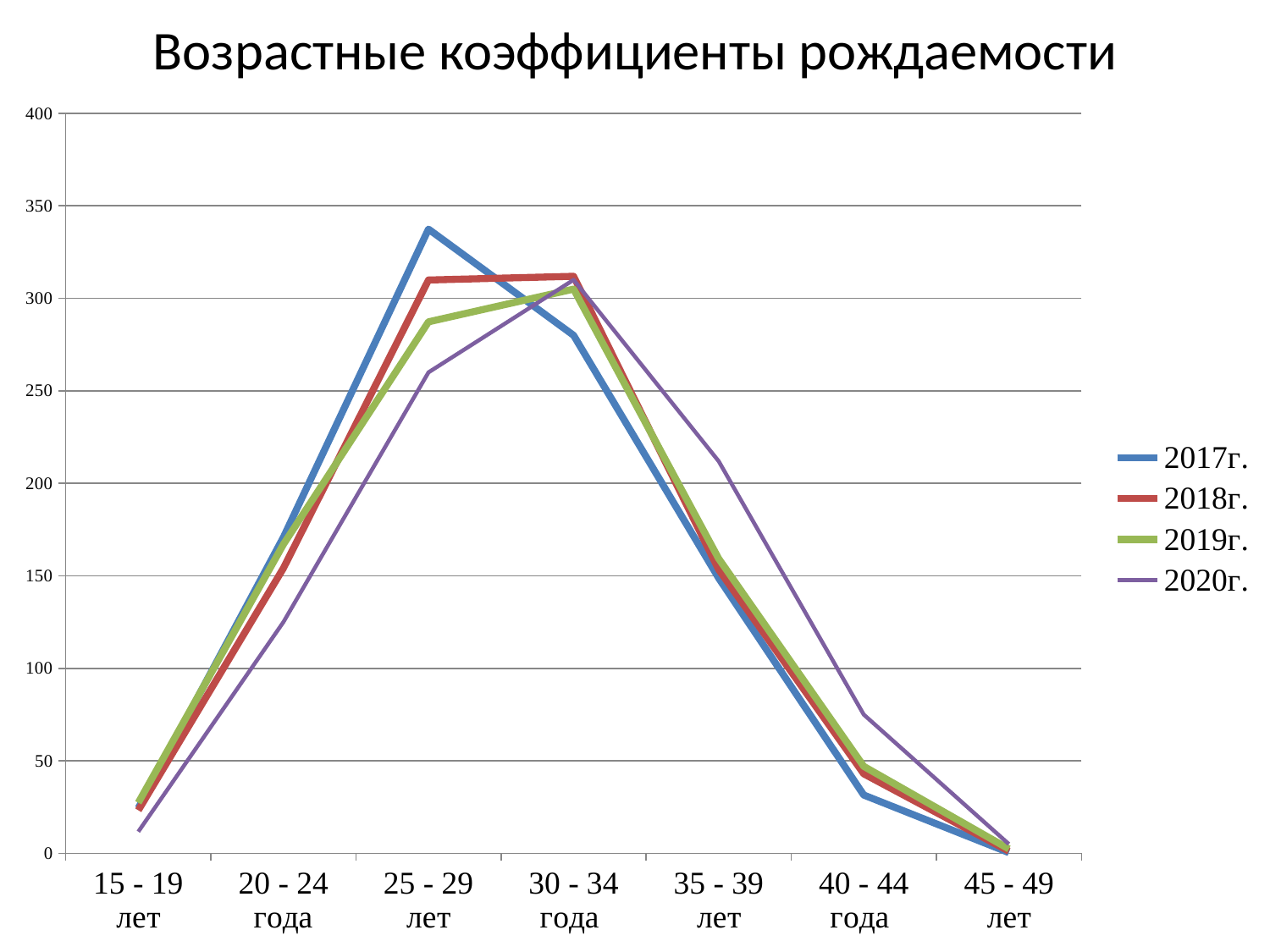
How many series does the legend list? 4 Is the 2020г. value for 40 - 44 года greater or less than 50? greater Is the 2020г. value for 25 - 29 лет greater or less than 300? less For the 35 - 39 лет age group, which series has the larger value, 2017г. or 2020г.? 2020г. For which age group is the 2017г. value highest? 25 - 29 лет For which age group is the 2020г. value lowest? 45 - 49 лет Is the 2017г. value for 25 - 29 лет greater or less than 300? greater Does the 2017г. line rise or fall from 30 - 34 года to 45 - 49 лет? fall For which age group is the 2020г. value highest? 30 - 34 года What is the title of the chart? Возрастные коэффициенты рождаемости What kind of chart is shown on the slide? line chart How many age groups are shown on the x axis? 7